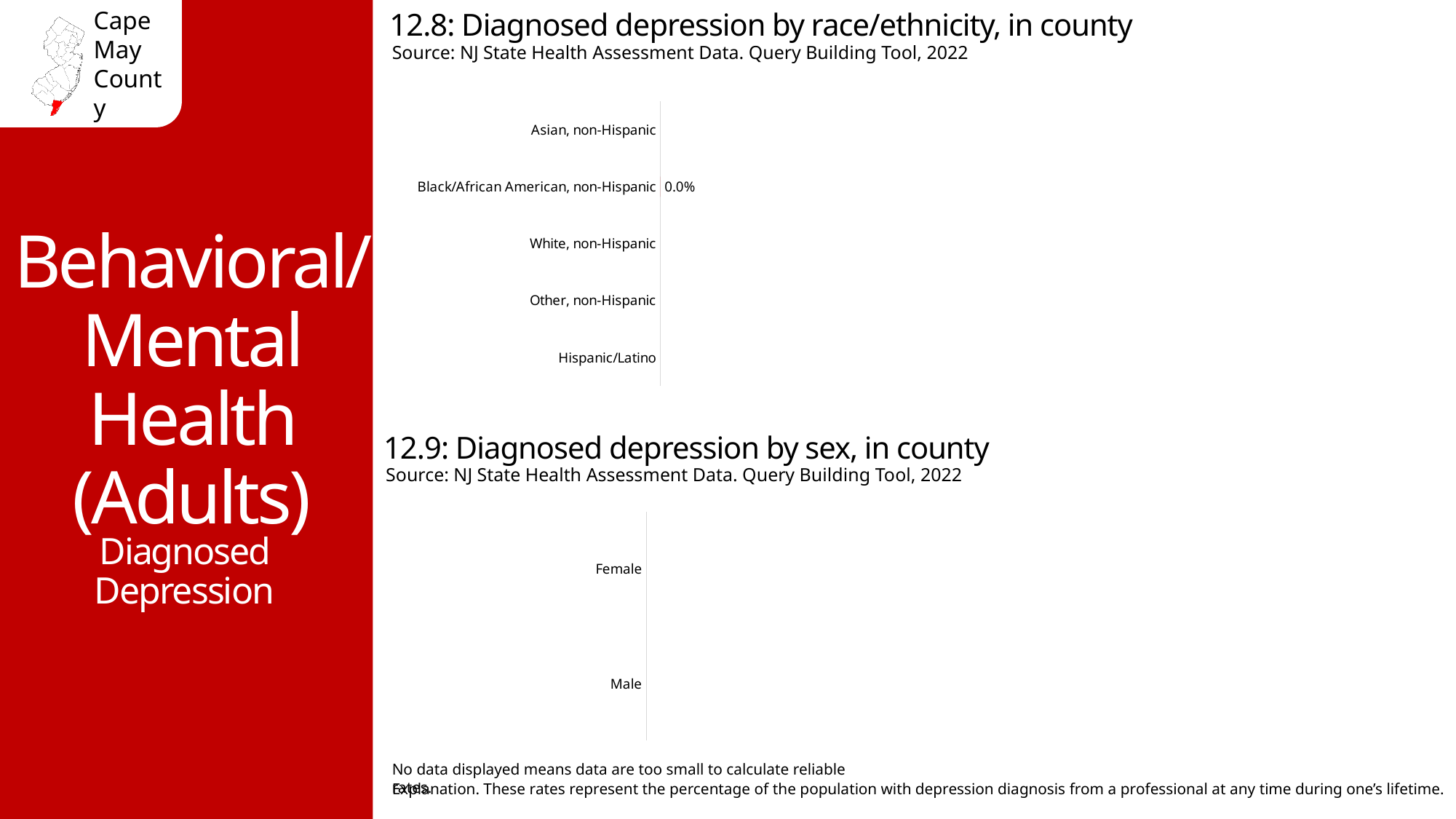
Which two categories are listed in the chart '12.9: Diagnosed depression by sex, in county'? Female and Male In the chart '12.8: Diagnosed depression by race/ethnicity, in county', what value is shown for Black/African American, non-Hispanic? 0.0% In the chart '12.9: Diagnosed depression by sex, in county', how many categories are listed? 2 What is the title of the top chart on the slide? 12.8: Diagnosed depression by race/ethnicity, in county In the chart '12.8: Diagnosed depression by race/ethnicity, in county', how many race/ethnicity categories are listed? 5 In the chart '12.8: Diagnosed depression by race/ethnicity, in county', which category has a data label of 0.0%? Black/African American, non-Hispanic